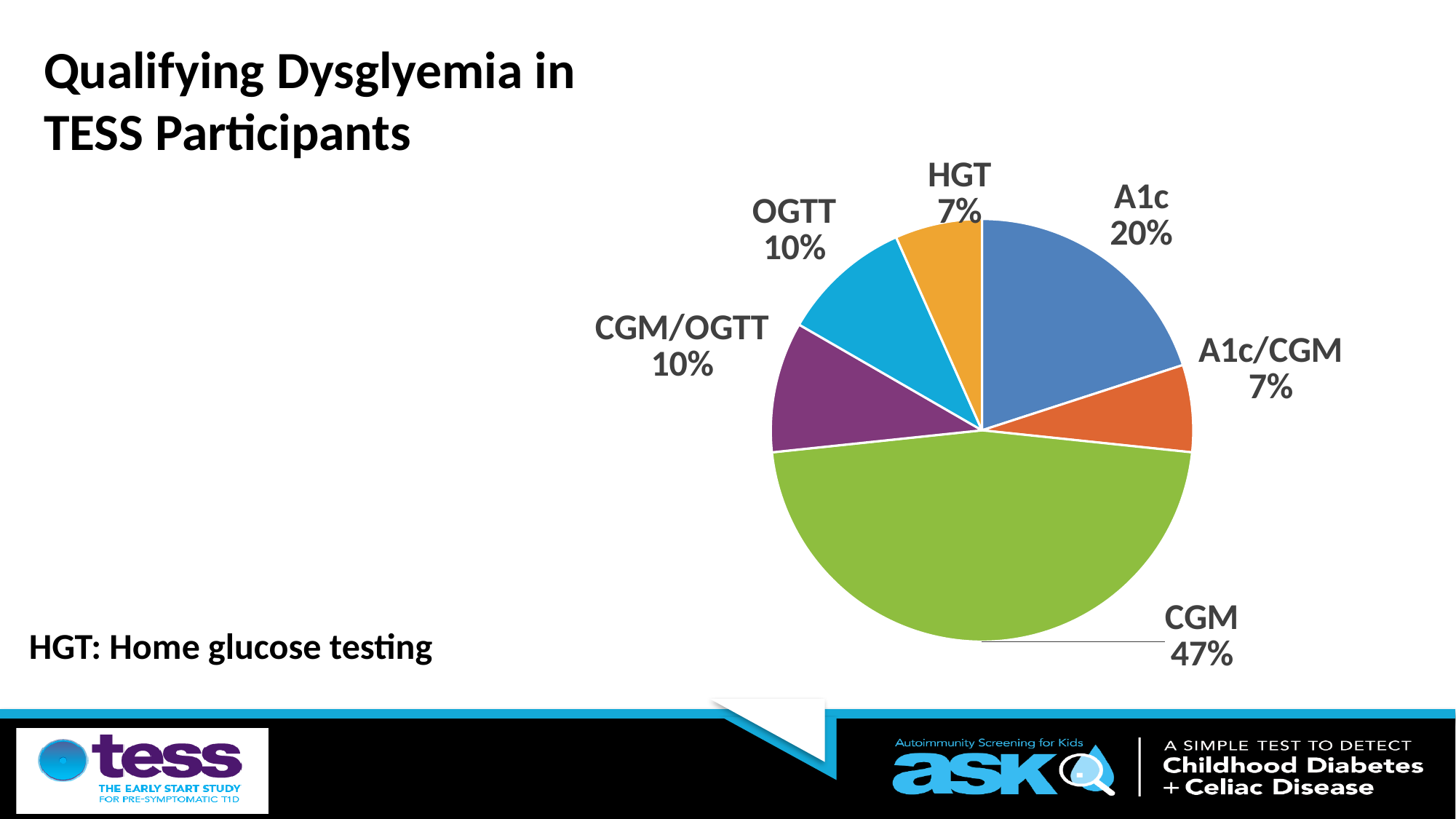
How many slices does the pie chart have? 6 Which category has the largest slice of the pie? CGM What kind of chart is shown on the slide? pie chart What percentage of the pie is A1c? 20% What percentage of the pie is CGM? 47% What percentage of the pie is OGTT? 10% What percentage of the pie is HGT? 7% What is the difference in percentage points between CGM and A1c? 27 What colour is the CGM slice of the pie? green What is the combined share of CGM/OGTT and OGTT? 20% What is the title of the slide containing the pie chart? Qualifying Dysglyemia in TESS Participants Which is larger, the A1c slice or the A1c/CGM slice? A1c